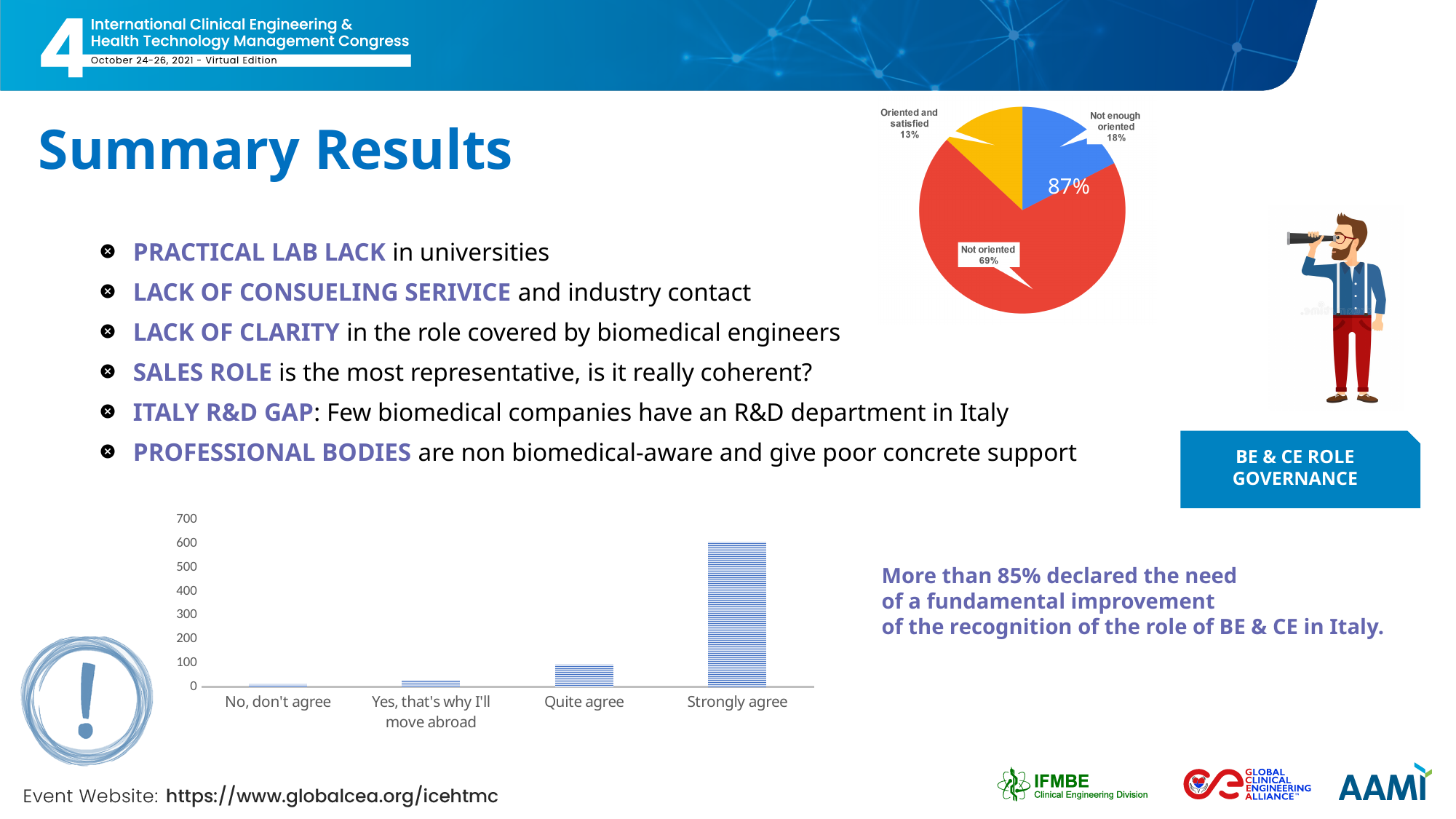
In the pie chart at the top right, what percentage is labelled 'Oriented and satisfied'? 13% In the bar chart at the bottom left, which category has the highest bar? Strongly agree In the bar chart at the bottom left, how many categories are shown on the x axis? 4 In the pie chart at the top right, which slice is the smallest? Oriented and satisfied In the pie chart at the top right, how many slices are there? 3 In the bar chart at the bottom left, is the value for 'Strongly agree' greater or less than 500? greater What type of chart is shown at the bottom left of the slide? Bar chart In the pie chart at the top right, what percentage is labelled 'Not oriented'? 69% In the pie chart at the top right, which slice is the largest? Not oriented In the pie chart at the top right, what percentage is labelled 'Not enough oriented'? 18% In the bar chart at the bottom left, is the value for 'Quite agree' greater or less than 200? less In the pie chart at the top right, what is the difference in percentage points between 'Not oriented' and 'Not enough oriented'? 51